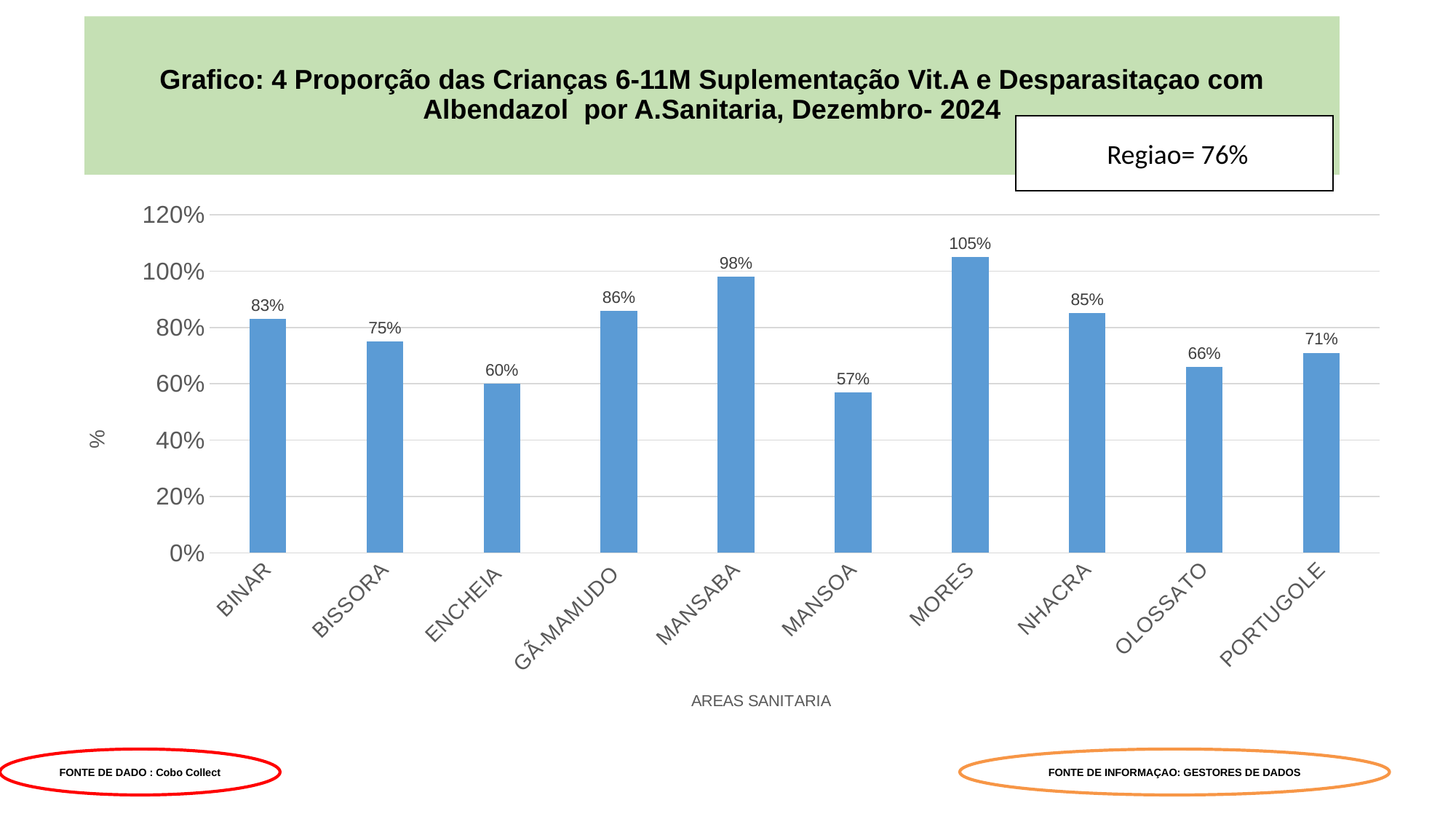
What regional value is shown in the box at the top right of the slide? 76% Which area has the lowest value? MANSOA What is the difference between the values for MORES and MANSOA? 48% What kind of chart is shown on the slide? bar chart Which is larger, the value for GÃ-MAMUDO or the value for PORTUGOLE? GÃ-MAMUDO What is the difference between the values for BINAR and BISSORA? 8% Which area has the highest value? MORES What is the value for ENCHEIA? 60% How many areas are shown on the x axis? 10 Is the value for NHACRA greater or less than 80%? greater What is the value for OLOSSATO? 66% What is the value for MANSABA? 98%